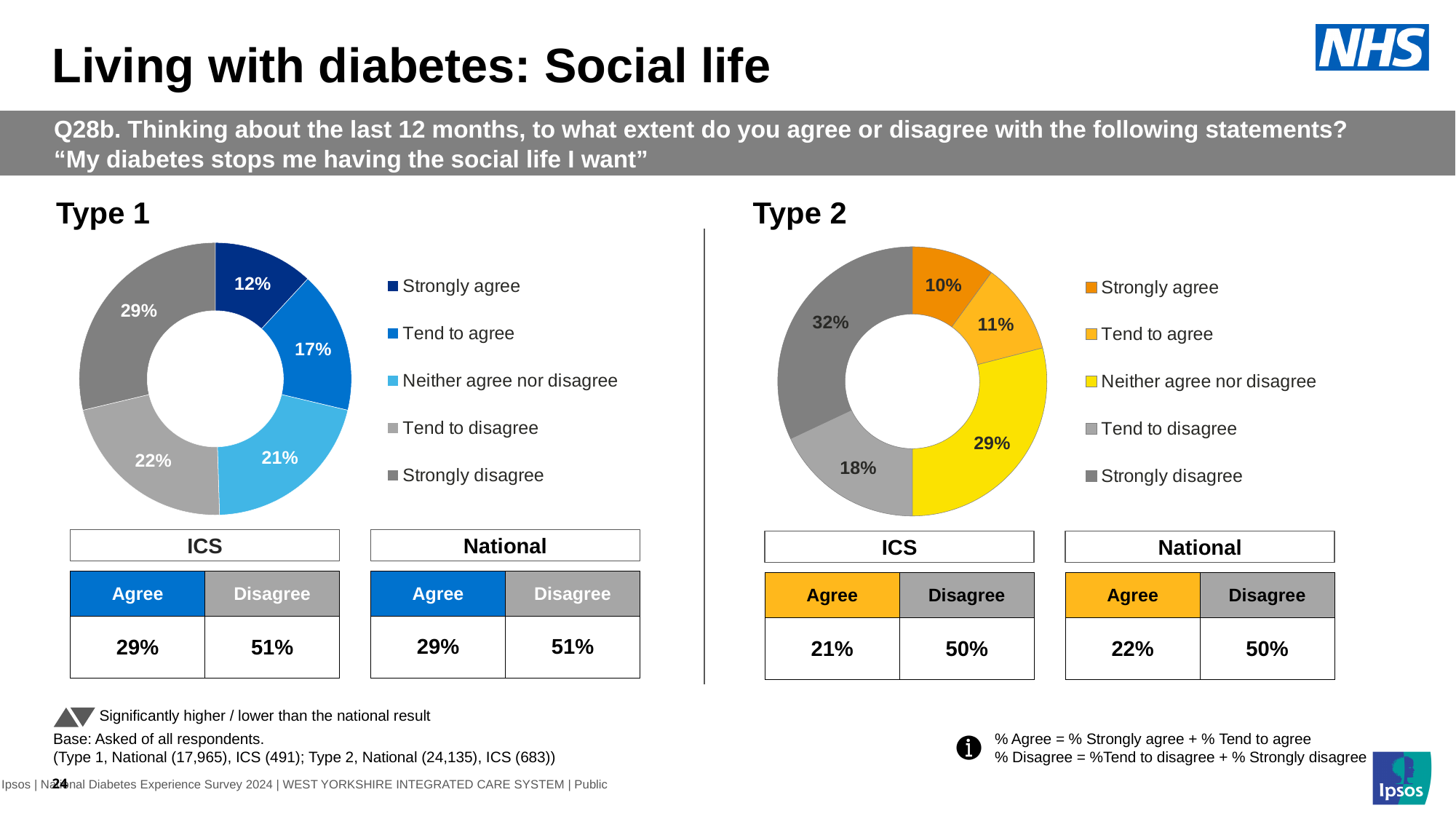
How many response categories does the legend of the Type 1 chart list? 5 In the Type 1 chart, what colour is the 'Strongly agree' segment? Dark blue In the Type 2 chart, what percentage of respondents said 'Tend to agree'? 11% In the Type 1 chart, which response category has the largest share? Strongly disagree In the Type 2 chart, what is the difference in percentage points between 'Strongly disagree' and 'Tend to disagree'? 14 In the Type 1 chart, what percentage of respondents said 'Strongly agree'? 12% In the Type 2 chart, which is larger: 'Neither agree nor disagree' or 'Tend to disagree'? Neither agree nor disagree In the Type 2 chart, which response category has the smallest share? Strongly agree In the Type 1 chart, what is the difference in percentage points between 'Strongly disagree' and 'Strongly agree'? 17 What kind of chart is used for the Type 2 results? Donut (pie) chart In the Type 1 chart, what percentage of respondents said 'Tend to disagree'? 22% In the Type 2 chart, what percentage of respondents said 'Neither agree nor disagree'? 29%